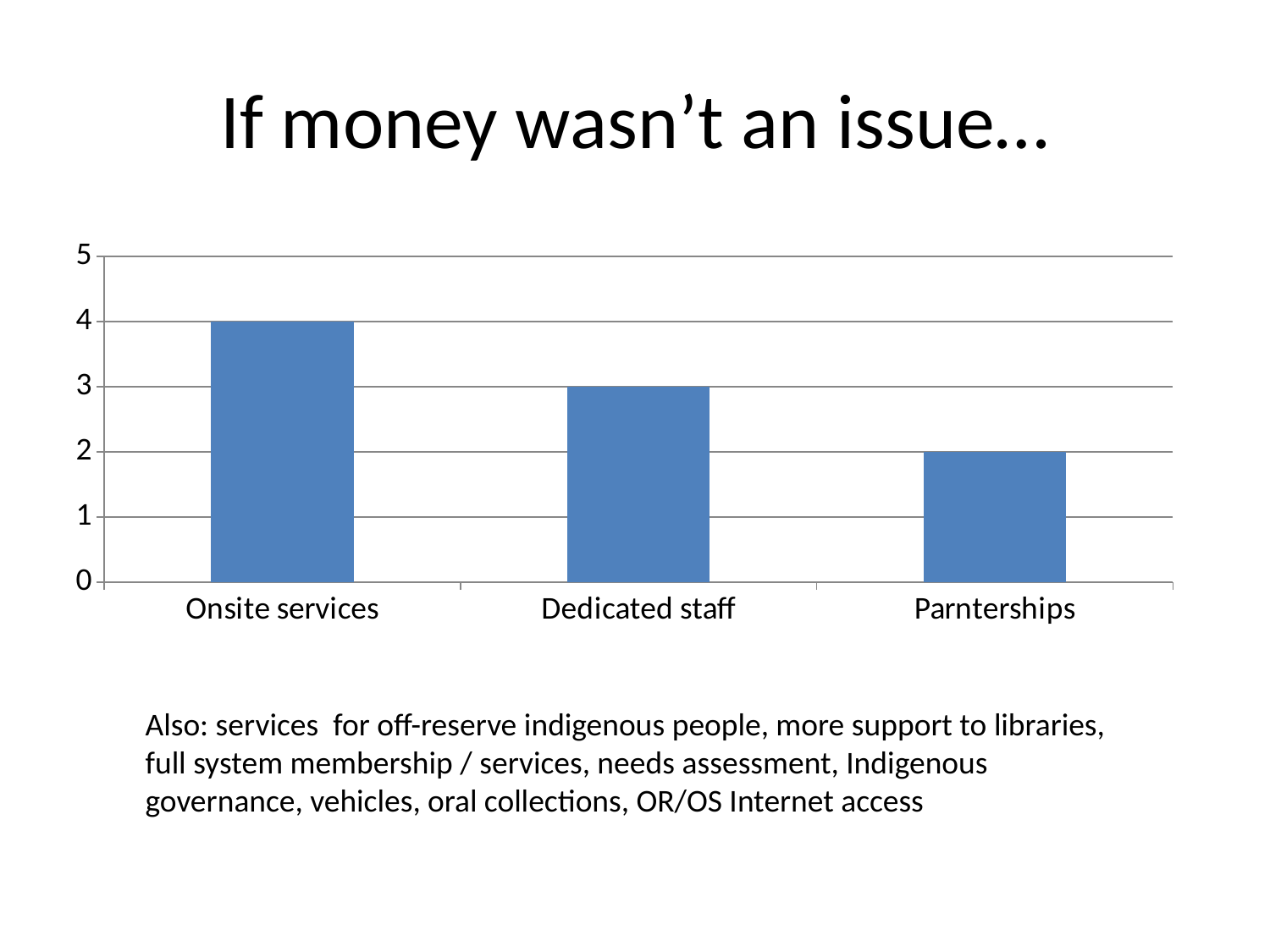
What is the value for Parnterships? 2 What is the difference between the values for Onsite services and Parnterships? 2 What is the difference between the values for Onsite services and Dedicated staff? 1 Which category has the lowest value? Parnterships Which is larger, the value for Dedicated staff or the value for Parnterships? Dedicated staff What is the value for Dedicated staff? 3 What is the title of the slide containing the chart? If money wasn't an issue... What kind of chart is shown on the slide? Bar chart Do the values rise or fall from left to right across the categories? Fall What is the value for Onsite services? 4 How many categories are shown in the chart? 3 Which category has the highest value? Onsite services